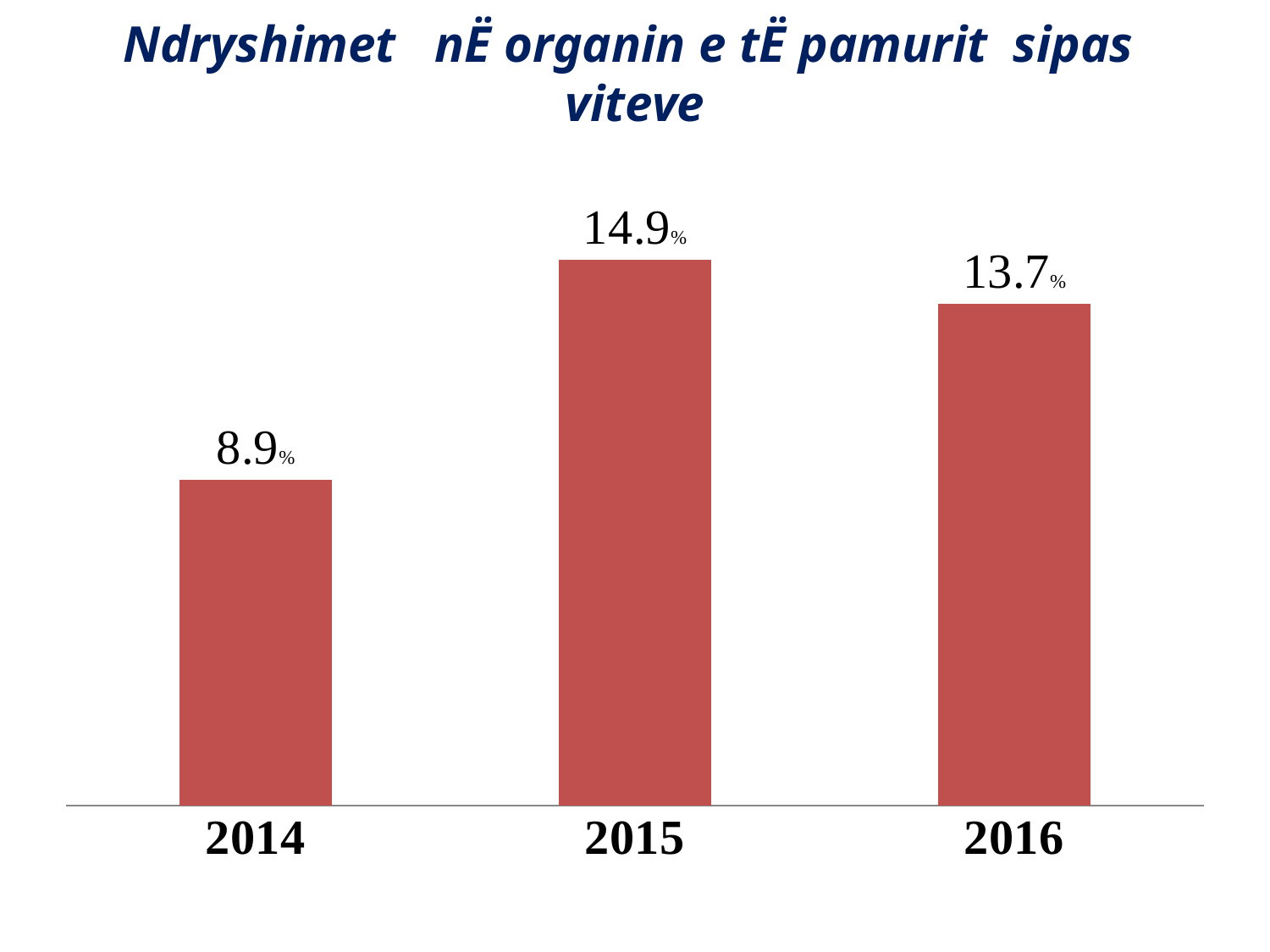
How many years are shown on the chart? 3 What kind of chart is shown on the slide? Bar chart What is the value for 2016? 13.7% Which is larger, the value for 2016 or the value for 2014? 2016 What is the difference between the values for 2015 and 2016? 1.2% Does the value rise or fall from 2015 to 2016? Fall What is the difference between the values for 2015 and 2014? 6.0% What is the value for 2015? 14.9% Which year has the highest value? 2015 What colour are the bars in the chart? Red Which year has the lowest value? 2014 What is the value for 2014? 8.9%